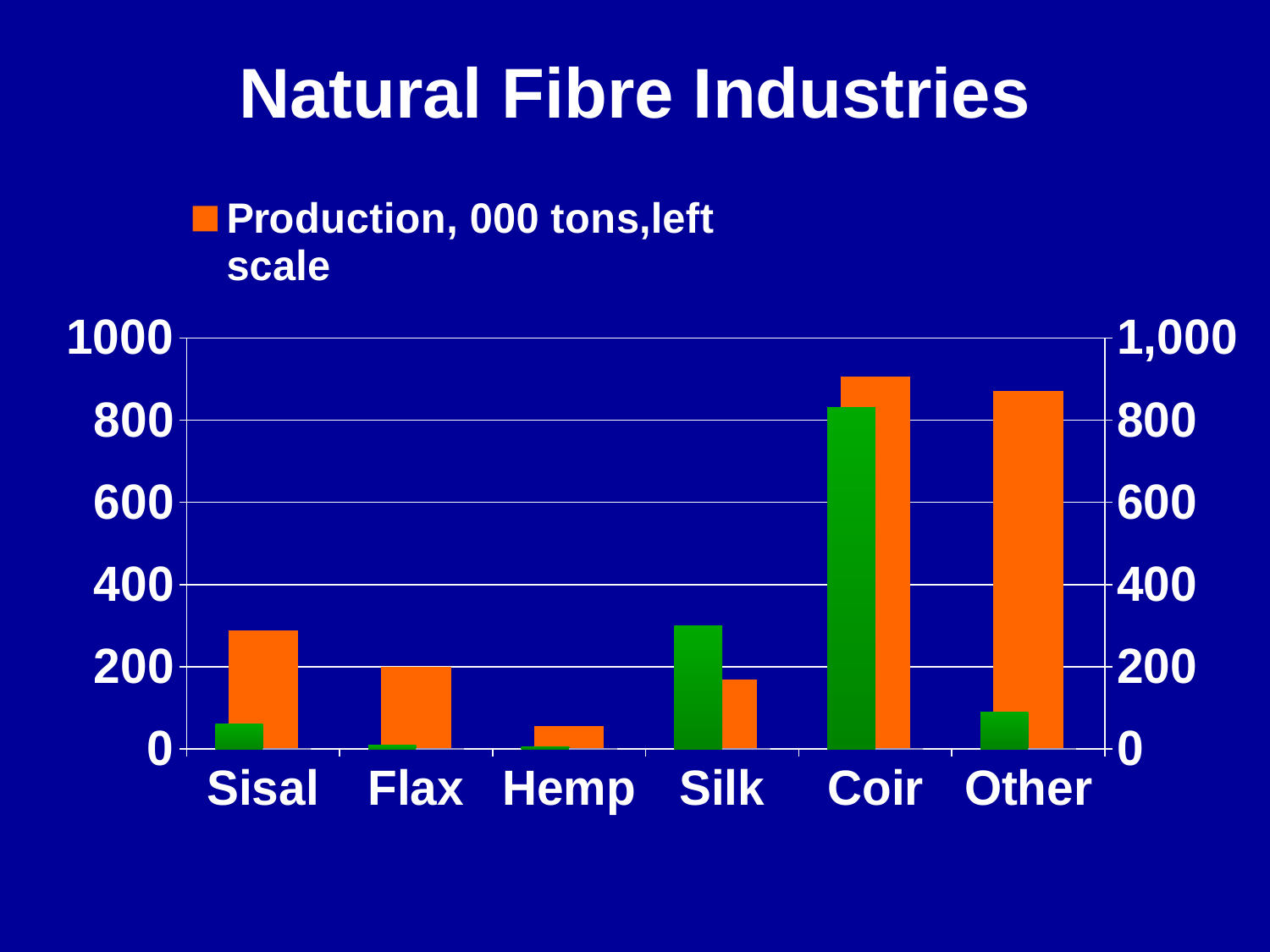
Which category has the highest value for Production, 000 tons? Coir Which has the larger Production value, Coir or Other? Coir How many categories are shown on the x axis of the chart? 6 Which has the larger Production value, Sisal or Flax? Sisal Is the Production value for Sisal greater or less than 200? greater How many series does the chart's legend list? 1 Is the Production value for Coir greater or less than 800? greater What kind of chart is shown on the slide? bar chart Is the Production value for Silk greater or less than 200? less What is the title of the slide containing the chart? Natural Fibre Industries Which category has the lowest value for Production, 000 tons? Hemp